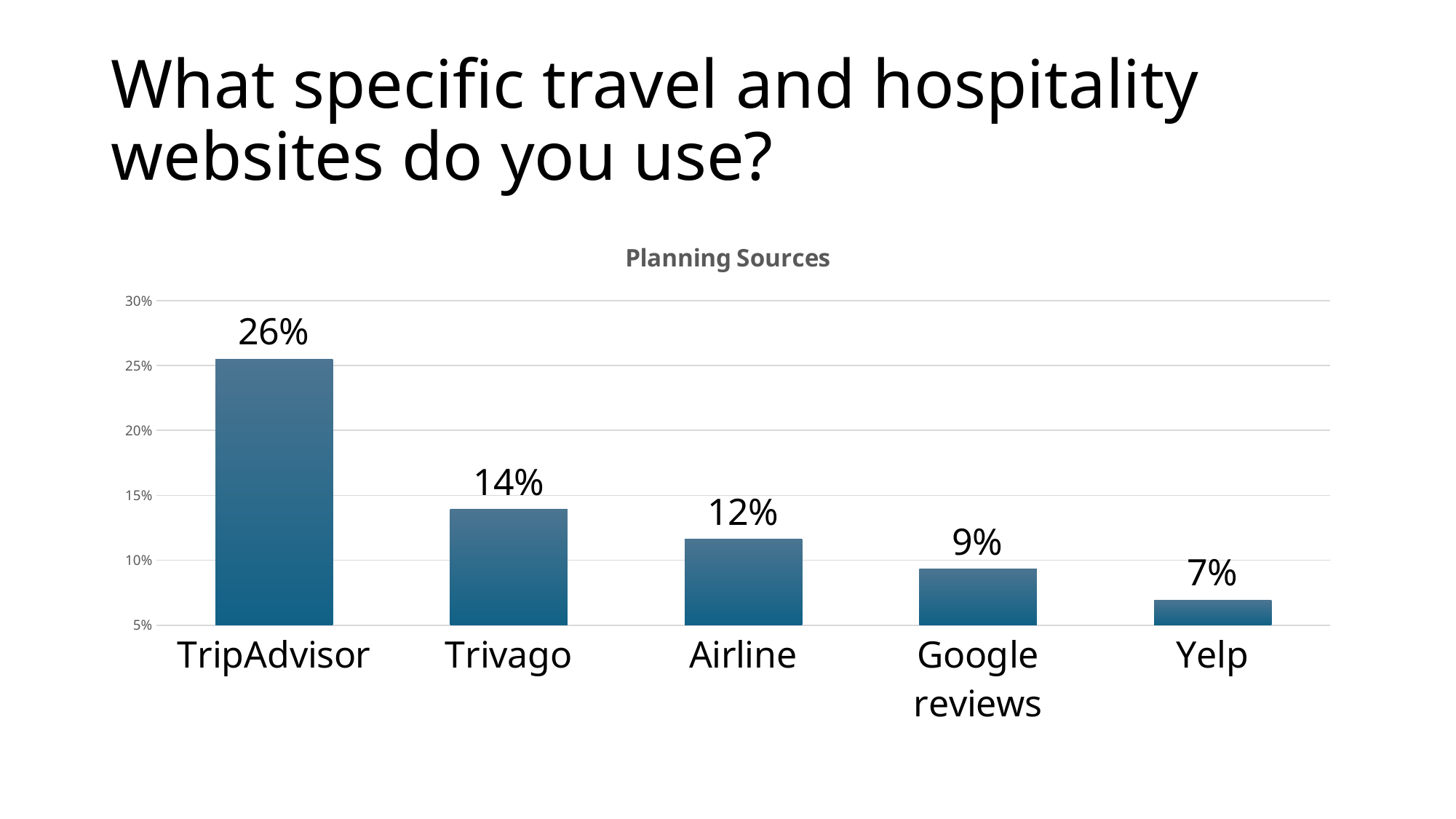
What is the difference between the values for TripAdvisor and Trivago? 12% What is the value for Google reviews? 9% What is the value for Trivago? 14% Is the value for Airline greater or less than 15%? less How many categories are shown on the chart? 5 Which category has the highest value? TripAdvisor What is the value for Yelp? 7% Which category has the lowest value? Yelp What kind of chart is shown on the slide? bar chart Which is larger, the value for Airline or the value for Google reviews? Airline What is the title of the chart? Planning Sources What is the value for TripAdvisor? 26%